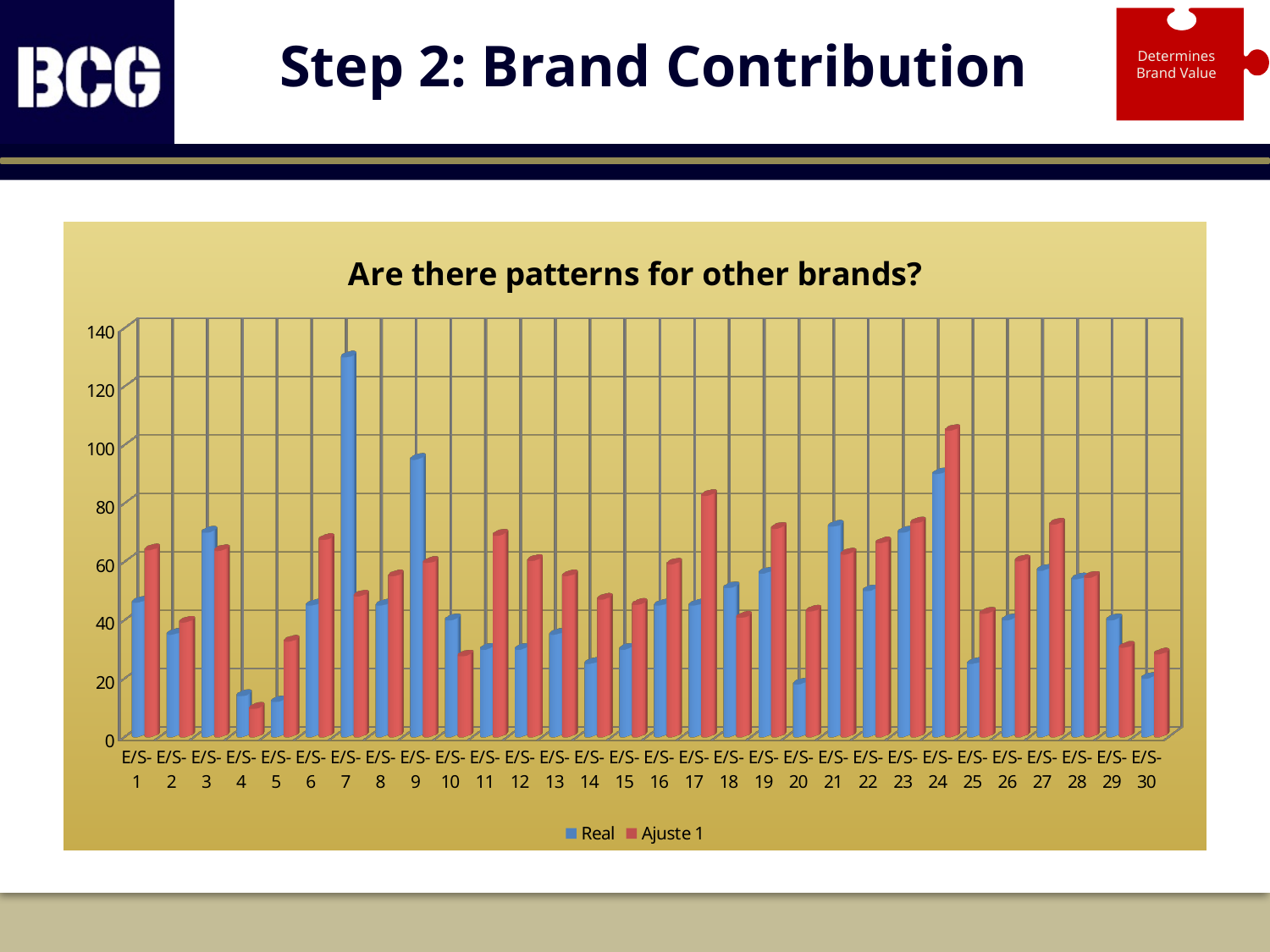
For E/S-17, which series has the larger value, Real or Ajuste 1? Ajuste 1 Which category has the highest Real value? E/S-7 What is the title of the chart? Are there patterns for other brands? Which category has the lowest Ajuste 1 value? E/S-4 How many series does the legend list? 2 Is the Ajuste 1 value for E/S-24 greater or less than 100? greater What are the names of the two series in the legend? Real and Ajuste 1 How many categories are shown on the x axis? 30 Is the Real value for E/S-20 greater or less than 40? less Which category has the highest Ajuste 1 value? E/S-24 What kind of chart is shown on the slide? Bar chart Is the Real value for E/S-7 greater or less than 120? greater